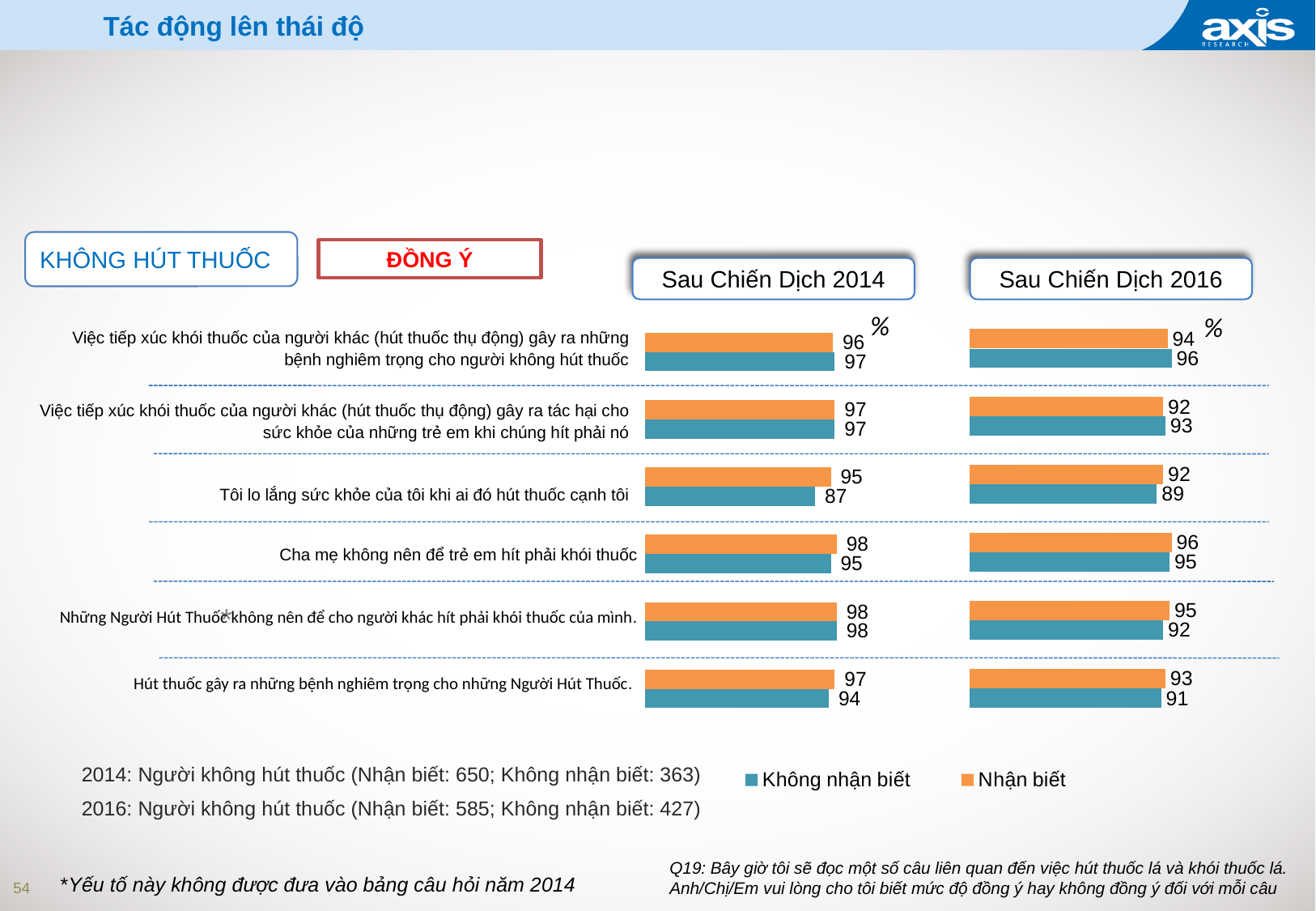
What type of chart is the 'Sau Chiến Dịch 2016' chart? Bar chart How many series does the legend list? 2 In the 'Sau Chiến Dịch 2016' chart, which category has the lowest 'Không nhận biết' value? Tôi lo lắng sức khỏe của tôi khi ai đó hút thuốc cạnh tôi In the 'Sau Chiến Dịch 2016' chart, what is the value for 'Nhận biết' for 'Cha mẹ không nên để trẻ em hít phải khói thuốc'? 96 In the 'Sau Chiến Dịch 2014' chart, which category has the lowest 'Không nhận biết' value? Tôi lo lắng sức khỏe của tôi khi ai đó hút thuốc cạnh tôi In the 'Sau Chiến Dịch 2014' chart, what is the value for 'Không nhận biết' for 'Tôi lo lắng sức khỏe của tôi khi ai đó hút thuốc cạnh tôi'? 87 In the 'Sau Chiến Dịch 2016' chart, for 'Việc tiếp xúc khói thuốc của người khác (hút thuốc thụ động) gây ra những bệnh nghiêm trọng cho người không hút thuốc', which series has the larger value, 'Nhận biết' or 'Không nhận biết'? Không nhận biết In the 'Sau Chiến Dịch 2014' chart, what is the value for 'Nhận biết' for 'Tôi lo lắng sức khỏe của tôi khi ai đó hút thuốc cạnh tôi'? 95 How many categories are shown in the 'Sau Chiến Dịch 2014' chart? 6 In the 'Sau Chiến Dịch 2016' chart, what is the value for 'Không nhận biết' for 'Hút thuốc gây ra những bệnh nghiêm trọng cho những Người Hút Thuốc'? 91 In the 'Sau Chiến Dịch 2016' chart, what is the difference between the 'Nhận biết' and 'Không nhận biết' values for 'Những Người Hút Thuốc không nên để cho người khác hít phải khói thuốc của mình'? 3 In the 'Sau Chiến Dịch 2014' chart, what is the difference between the 'Nhận biết' and 'Không nhận biết' values for 'Tôi lo lắng sức khỏe của tôi khi ai đó hút thuốc cạnh tôi'? 8